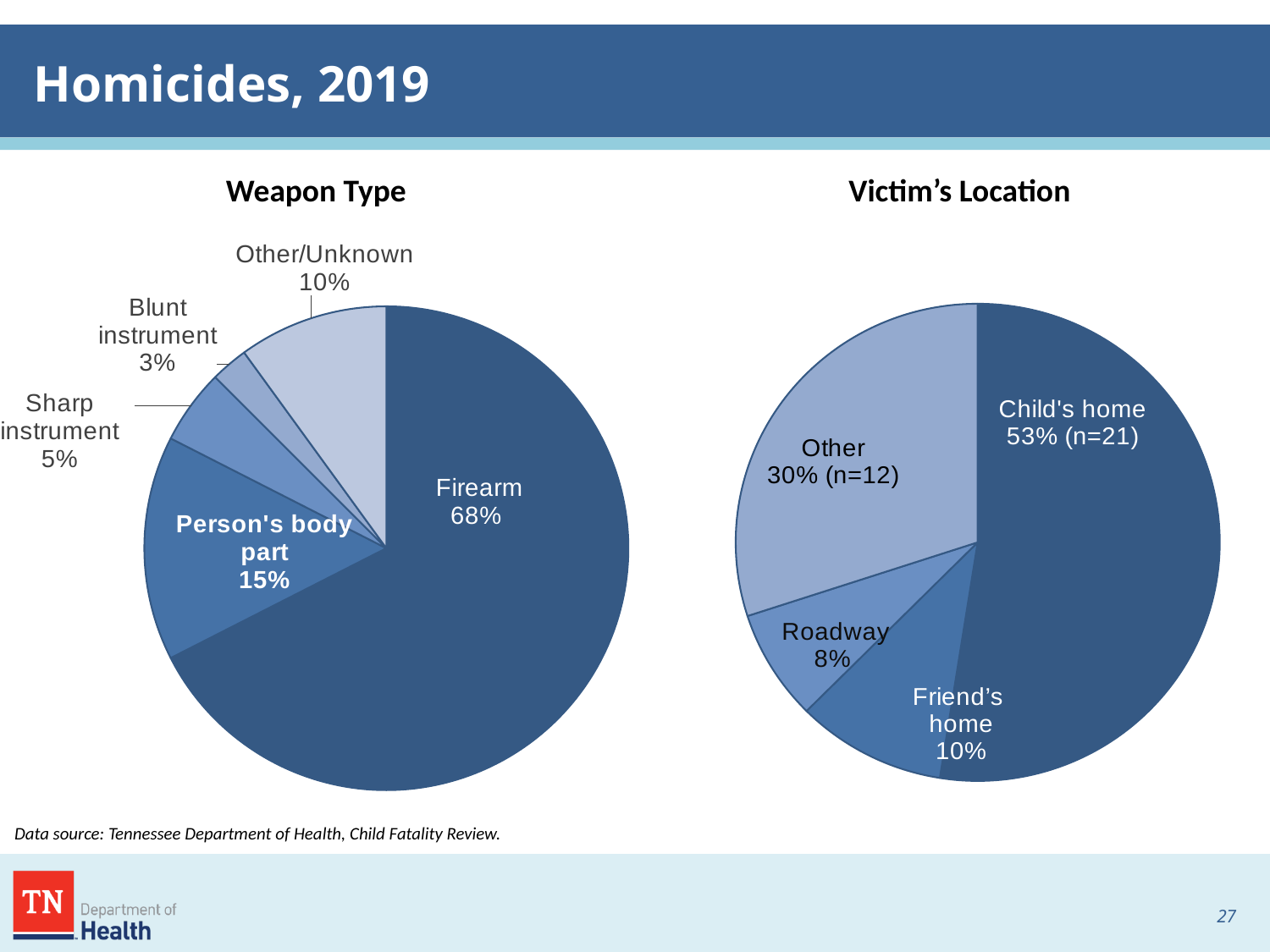
In the Weapon Type chart, what percentage is shown for Person's body part? 15% In the Weapon Type chart, what share of homicides involved a firearm? 68% In the Weapon Type chart, which weapon type has the smallest share? Blunt instrument What kind of chart is used for Victim's Location? Pie chart In the Victim's Location chart, which is larger: the share for Other or the share for Roadway? Other In the Victim's Location chart, which location has the smallest share? Roadway What is the title of the slide? Homicides, 2019 In the Weapon Type chart, what is the difference in percentage points between Firearm and Person's body part? 53 In the Victim's Location chart, what percentage of victims were at a friend's home? 10% In the Victim's Location chart, how many homicides occurred in the child's home? 21 In the Weapon Type chart, how many slices does the pie have? 5 In the Weapon Type chart, which weapon type has the largest share? Firearm